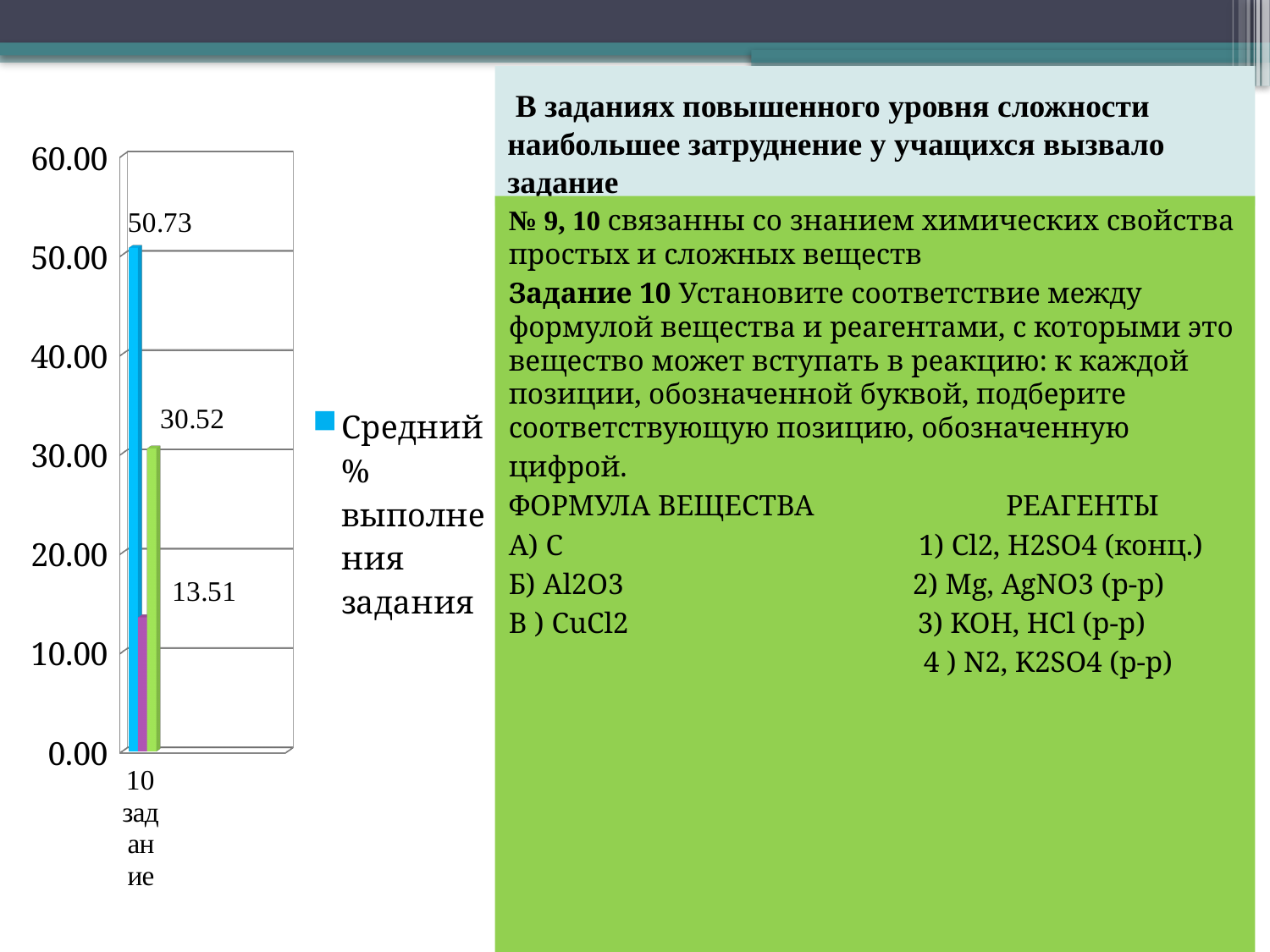
What is the value shown on the purple bar? 13.51 What is the difference between the blue bar (50.73) and the green bar (30.52)? 20.21 Is the value of the purple bar greater or less than 20.00? less Which bar is taller, the blue bar or the green bar? the blue bar How many categories are shown on the x axis of the chart? 1 What is the value shown on the tallest (blue) bar? 50.73 What is the difference between the blue bar (50.73) and the purple bar (13.51)? 37.22 What is the highest value labelled on the chart? 50.73 What kind of chart is shown on the slide? bar chart What is the value shown on the green bar? 30.52 What is the highest tick value shown on the vertical axis of the chart? 60.00 What is the lowest value labelled on the chart? 13.51